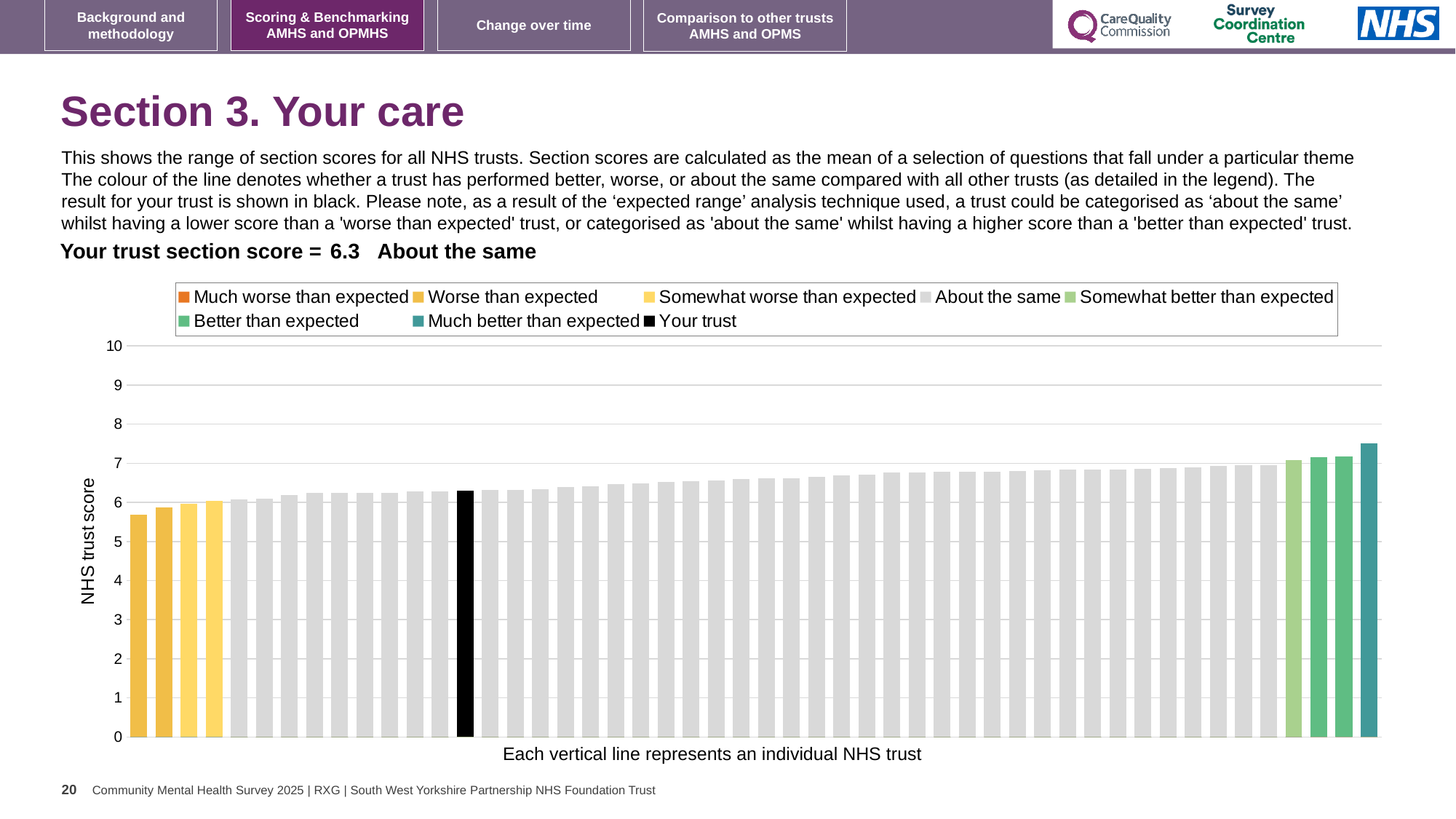
Is the value for the black bar (your trust) greater or less than 7? less What is the section score for your trust shown on the slide? 6.3 What kind of chart is used to show the NHS trust section scores? Bar chart What is the label on the vertical axis of the chart? NHS trust score Is the value for the shortest bar (leftmost trust) greater or less than 6? less What colour is used for the bar representing your trust? Black Is the value for the black bar (your trust) greater or less than 6? greater Which category is your trust placed in for Section 3. Your care? About the same Do the NHS trust scores rise or fall from left to right along the x axis? Rise How many entries does the chart legend list? 8